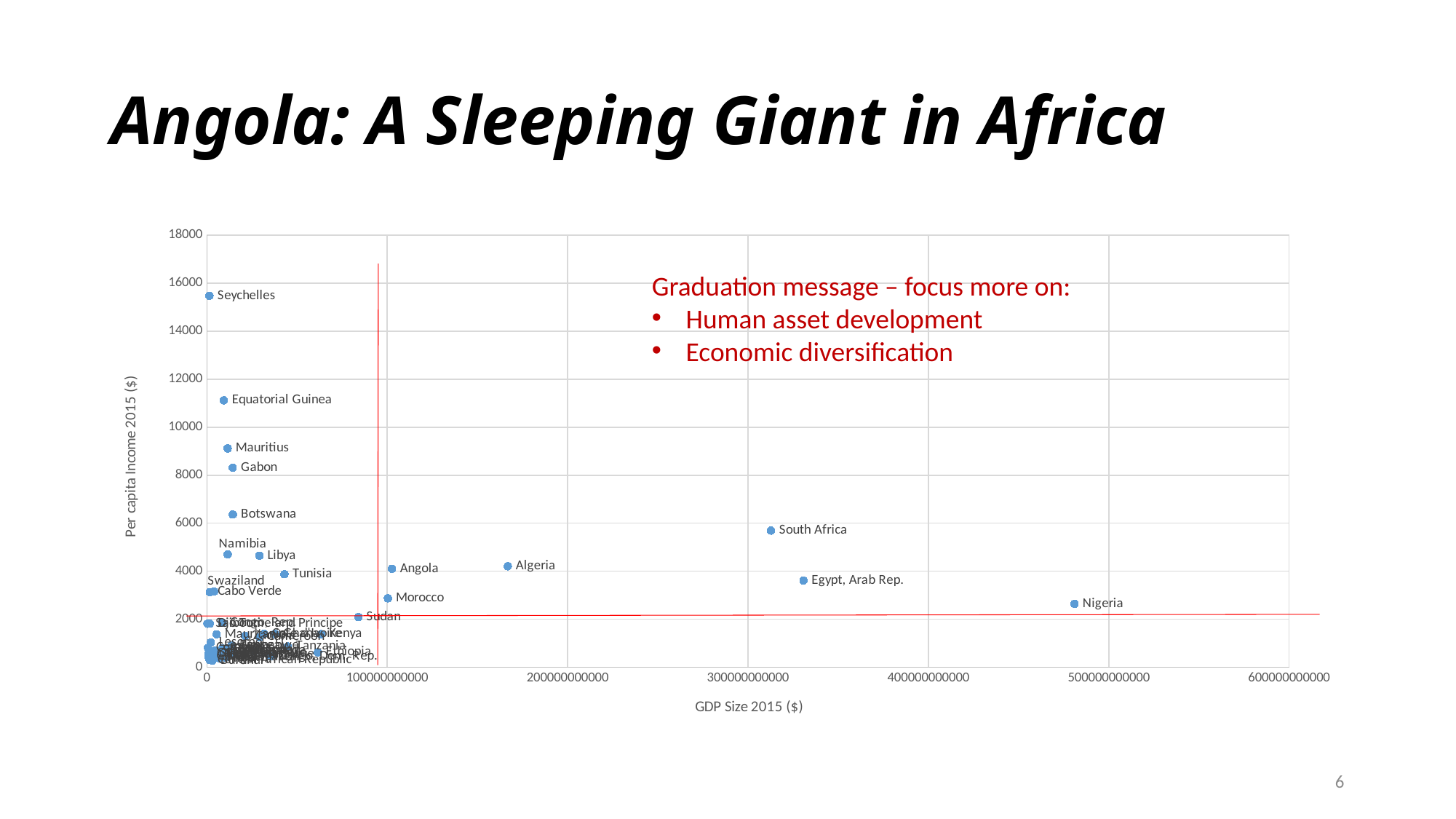
Which has a higher per capita income, Seychelles or Equatorial Guinea? Seychelles Which country has the highest per capita income in the chart? Seychelles Is the per capita income for Equatorial Guinea greater or less than 10000? greater Is the per capita income for Morocco greater or less than 4000? less Is the GDP size for Algeria greater or less than 200000000000? less What is the title of the horizontal axis of the chart? GDP Size 2015 ($) Which country has the largest GDP size in the chart? Nigeria Which has a larger GDP size, Nigeria or South Africa? Nigeria What kind of chart is shown on the slide? scatter chart